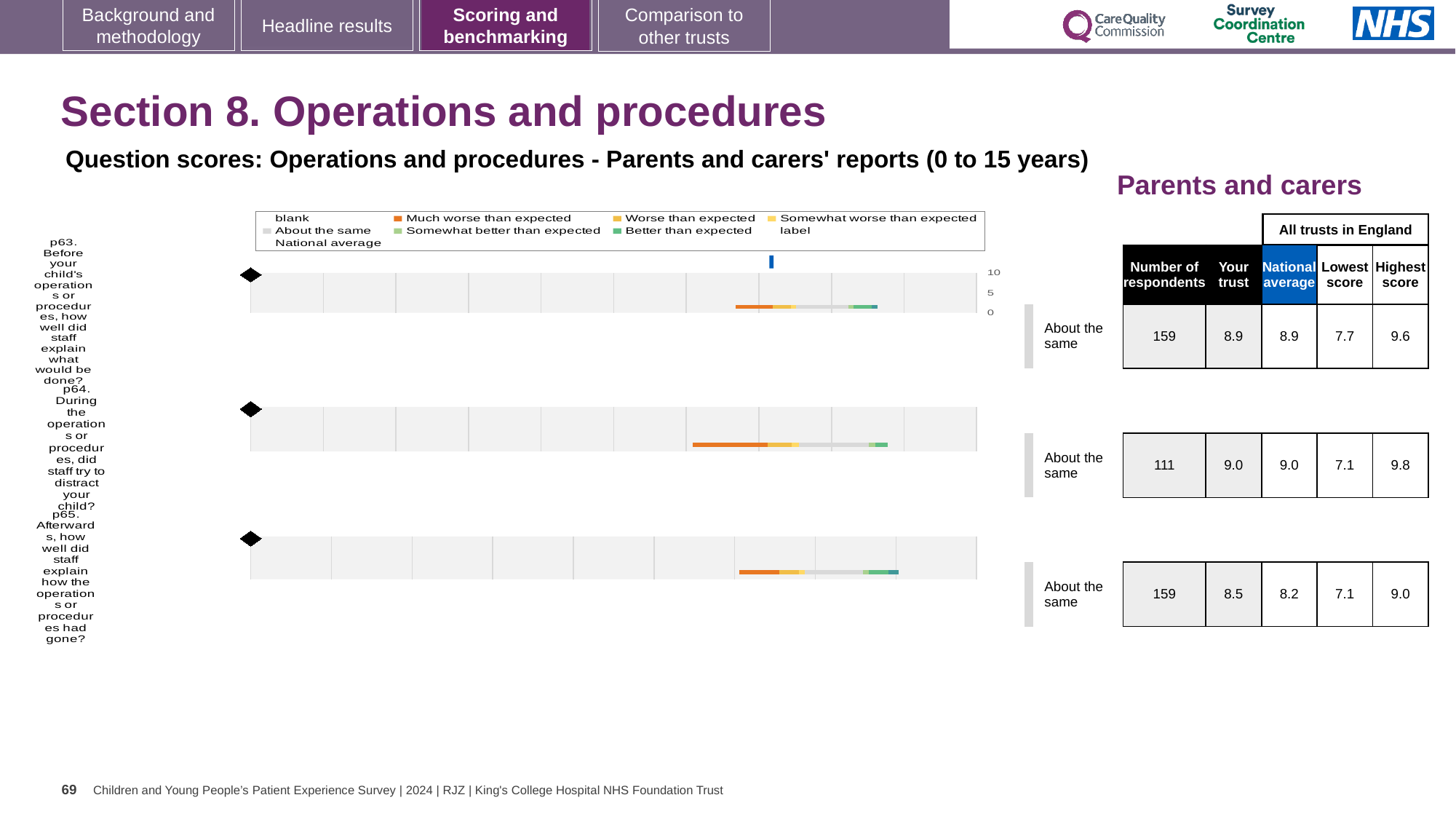
What is the national average score for p65 (Afterwards, how well did staff explain how the operations or procedures had gone?)? 8.2 How many questions (chart rows) are plotted on the slide? 3 What is the 'Your trust' score for p63 (Before your child's operations or procedures, how well did staff explain what would be done?)? 8.9 Which question has the highest 'Your trust' score? p64 What is the highest score among all trusts in England for p64? 9.8 Which is larger: the 'Your trust' score for p63 or for p65? p63 What is the lowest score among all trusts in England for p63? 7.7 For p65, what is the difference between the 'Your trust' score and the national average? 0.3 What kind of chart is used to show the question scores for p63, p64 and p65? bar chart Which question has the lowest 'Your trust' score? p65 How many respondents answered p64 (During the operations or procedures, did staff try to distract your child?)? 111 What benchmark category is shown next to each of the three question charts? About the same